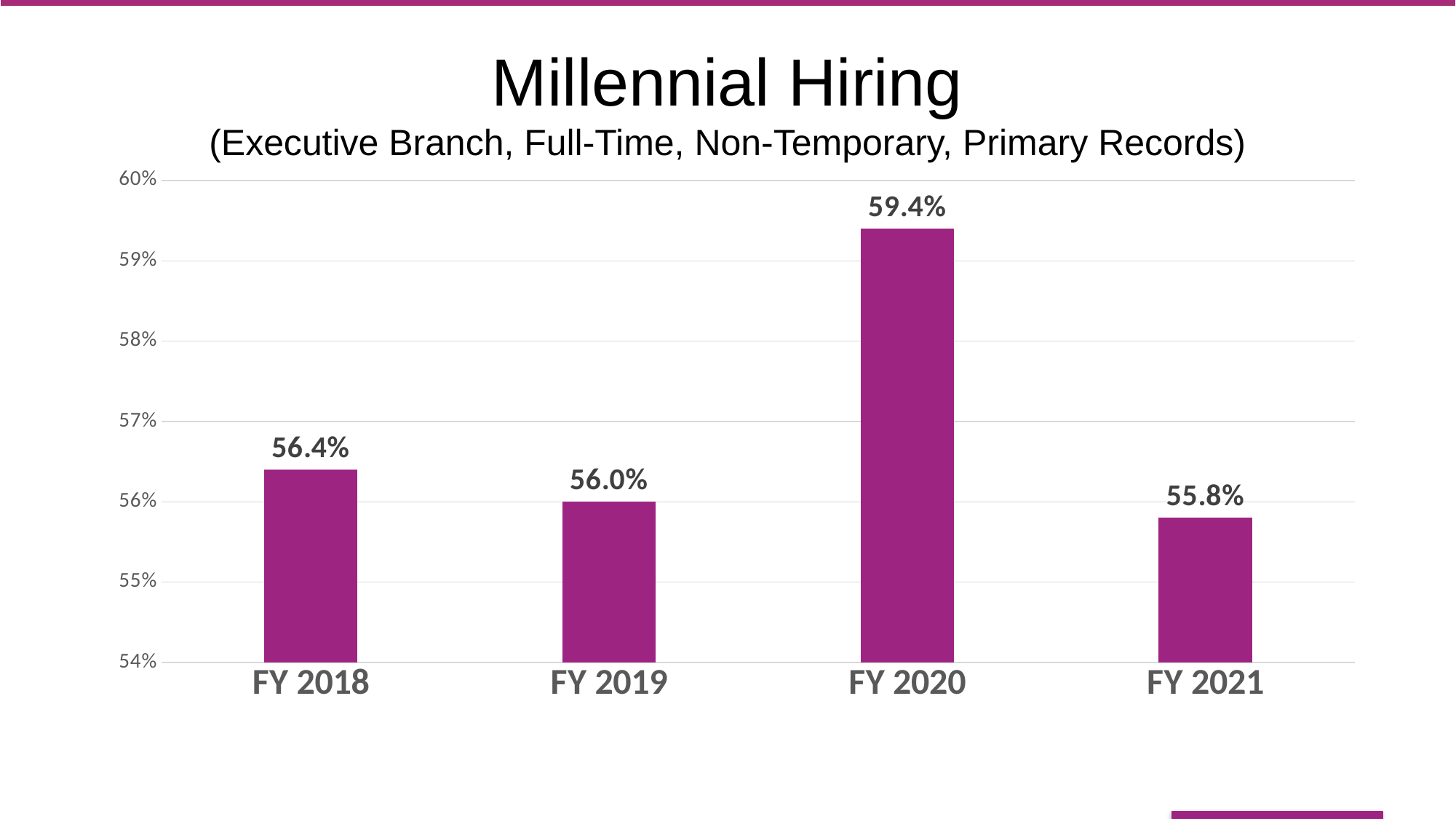
Which fiscal year has the highest value? FY 2020 Which is larger, the value for FY 2018 or the value for FY 2020? FY 2020 What is the value for FY 2021? 55.8% What is the value for FY 2018? 56.4% What is the value for FY 2020? 59.4% What is the value for FY 2019? 56.0% Which fiscal year has the lowest value? FY 2021 What kind of chart is shown on the slide? Bar chart Is the value for FY 2020 greater or less than 59%? greater What is the difference between the FY 2018 and FY 2019 values? 0.4% How many fiscal years are shown on the chart? 4 What is the difference between the FY 2020 and FY 2021 values? 3.6%